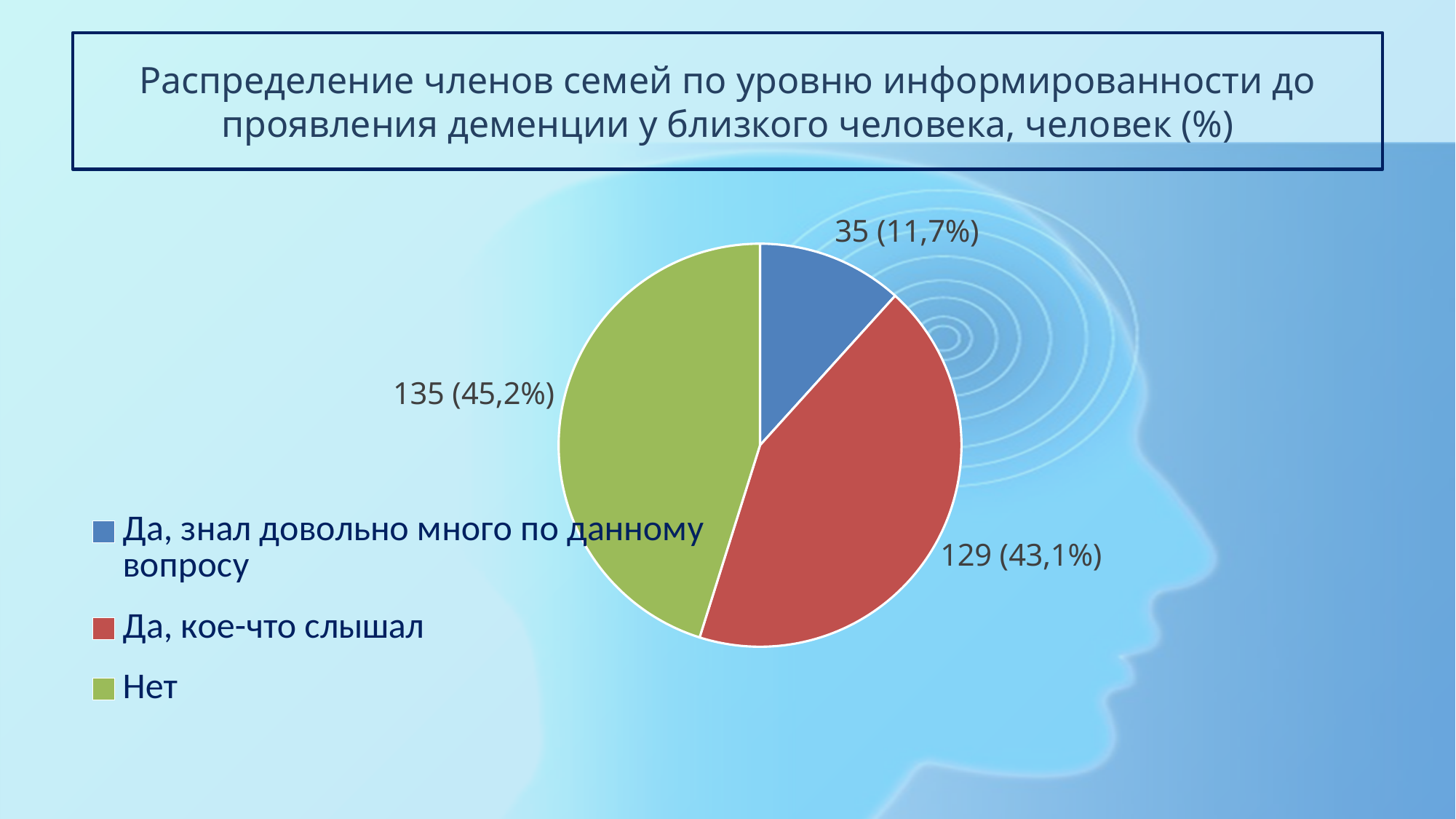
What kind of chart is shown on the slide? pie chart What is the data label for the "Нет" slice? 135 (45,2%) What is the data label for the "Да, кое-что слышал" slice? 129 (43,1%) What is the difference in number of people between "Нет" and "Да, кое-что слышал"? 6 What share of the pie does the "Да, кое-что слышал" slice represent? 43,1% What colour is the "Нет" slice? green Which category has the largest slice? Нет How many categories does the pie chart have? 3 Which is larger: the number of people for "Да, кое-что слышал" or for "Да, знал довольно много по данному вопросу"? Да, кое-что слышал What is the total number of people across all three slices? 299 Which category has the smallest slice? Да, знал довольно много по данному вопросу What is the data label for the "Да, знал довольно много по данному вопросу" slice? 35 (11,7%)